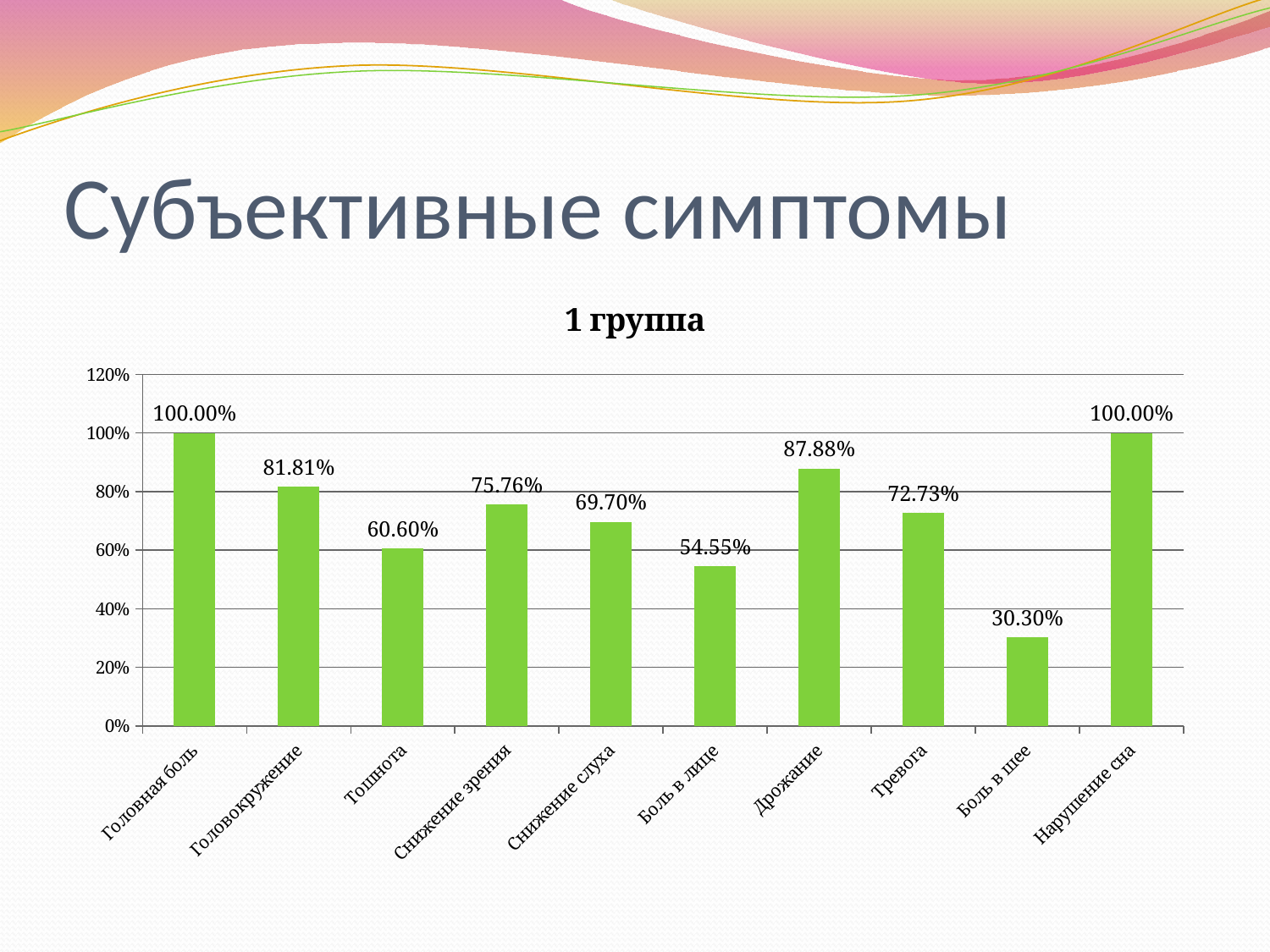
What kind of chart is shown on the slide? bar chart What is the value for Тошнота? 60.60% What is the difference between the values for Головокружение and Тревога? 9.08% What is the title of the chart? 1 группа How many categories are shown on the chart? 10 What is the value for Боль в шее? 30.30% What is the value for Дрожание? 87.88% Which category has the lowest value? Боль в шее What is the value for Снижение слуха? 69.70% Is the value for Тревога greater or less than 80%? less Which is larger, the value for Снижение зрения or the value for Боль в лице? Снижение зрения How many categories have a value of 100.00%? 2